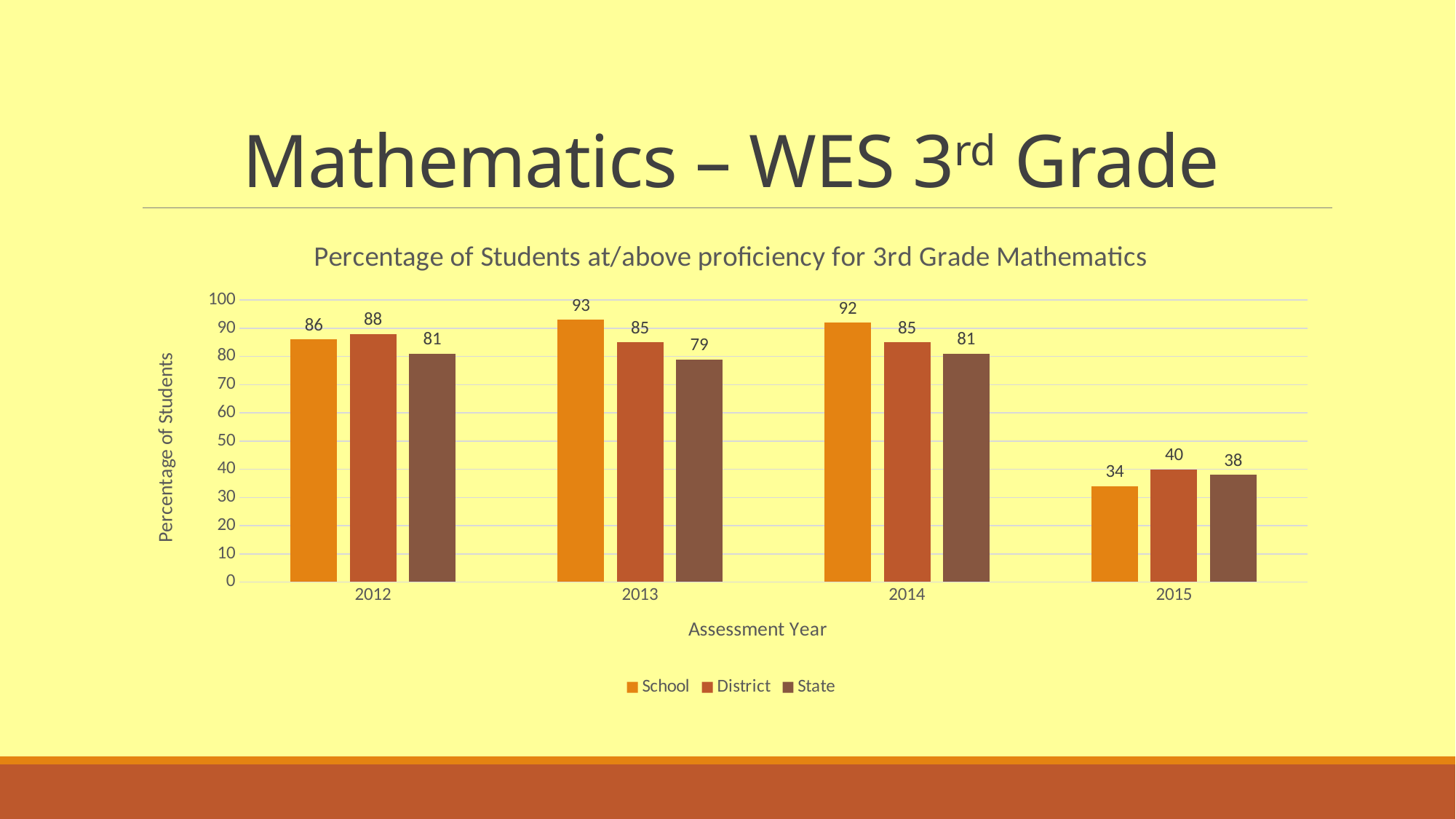
What is the State value for 2015? 38 How many assessment years are shown on the x axis? 4 How many series does the legend list? 3 What is the title of the chart? Percentage of Students at/above proficiency for 3rd Grade Mathematics What kind of chart is shown on the slide? Bar chart In which year is the School value highest? 2013 What is the District value for 2012? 88 Which is larger in 2015, the School value or the District value? District Does the State value rise or fall from 2014 to 2015? Fall In which year is the District value lowest? 2015 What is the School value for 2013? 93 What is the difference between the School and State values in 2013? 14